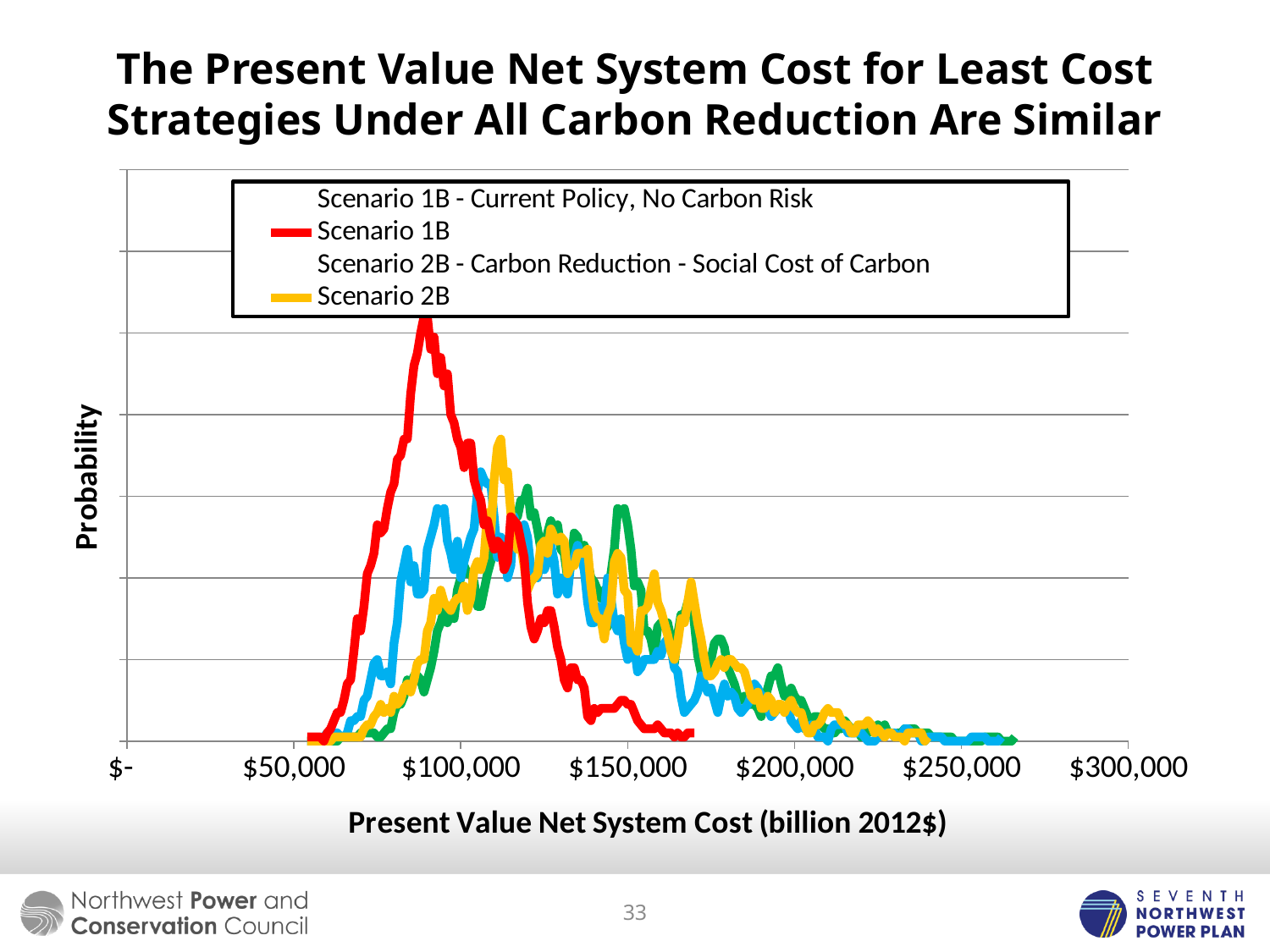
Which line ends at the lowest cost on the x axis, the red Scenario 1B line or the yellow Scenario 2B line? Scenario 1B What is the largest value labelled on the x axis? $300,000 What kind of chart is shown on the slide? line chart Which scenario is drawn in red? Scenario 1B Which scenario's line reaches the highest probability peak? Scenario 1B Does the Scenario 1B (red) line extend beyond $200,000 on the x axis? No How many tick labels are shown on the x axis? 7 How many legend entries have a coloured line sample next to them? 2 Is the peak of the Scenario 1B line at a cost greater or less than $100,000? less Which scenario's peak is further to the right on the x axis, Scenario 1B or Scenario 2B? Scenario 2B What is the title of the x axis? Present Value Net System Cost (billion 2012$) Is the peak of the Scenario 2B line at a cost greater or less than $100,000? greater